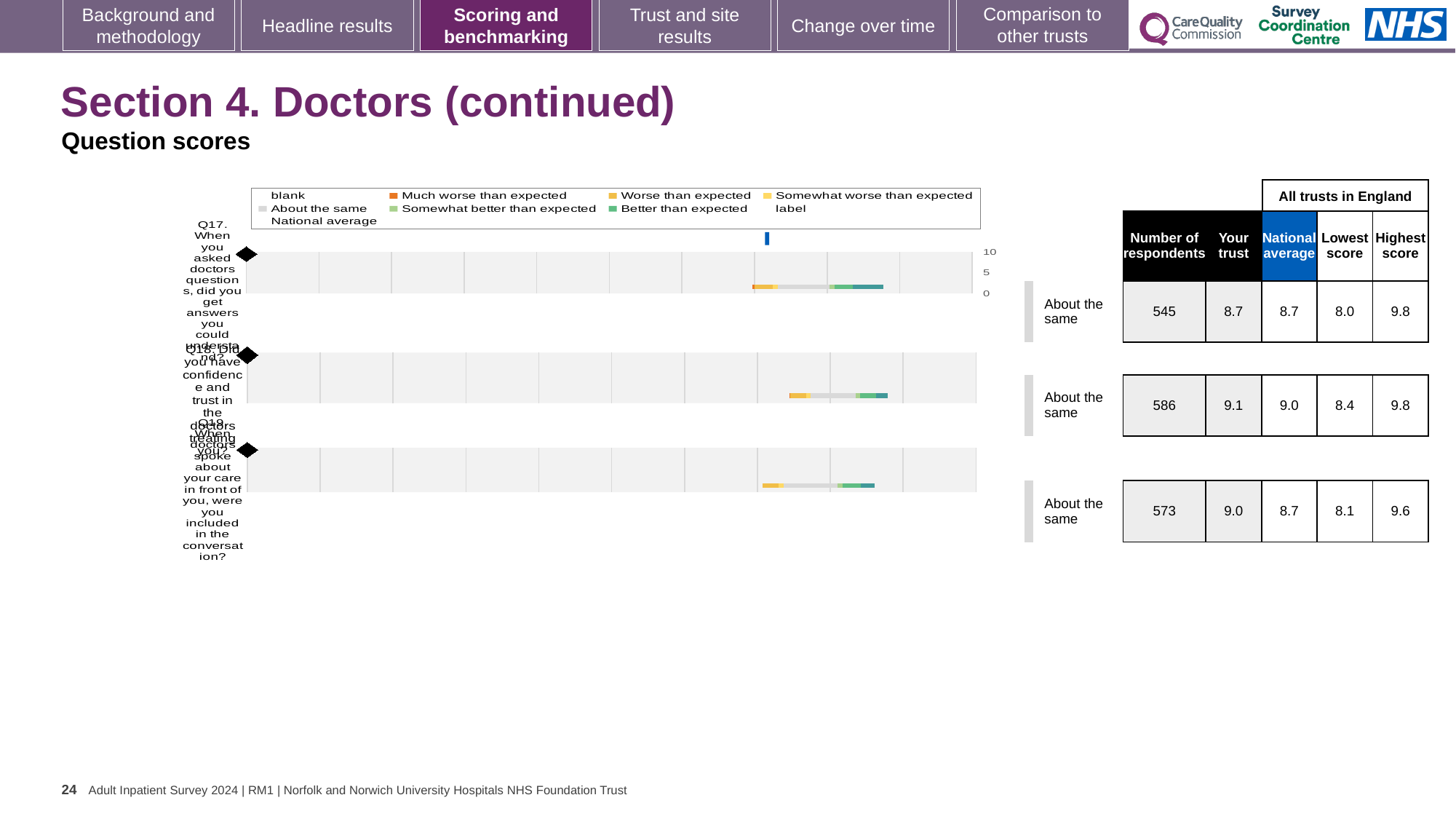
For Q18, which is larger: the 'Your trust' score or the national average? Your trust According to the table beside the chart, how many respondents answered Q19? 573 How many questions (categories) are plotted in the chart? 3 What benchmark category is shown for all three questions on the chart? About the same What is the maximum value shown on the chart's score axis? 10 What kind of chart is shown on the slide? bar chart According to the table beside the chart, what is the national average for Q18? 9.0 According to the table beside the chart, what is the 'Your trust' score for Q17? 8.7 Which question has the lowest 'Lowest score' value in the table beside the chart? Q17 According to the table beside the chart, what is the highest score across all trusts in England for Q19? 9.6 Which question has the highest 'Your trust' score in the table beside the chart? Q18 What is the difference between the 'Your trust' score and the national average for Q19? 0.3